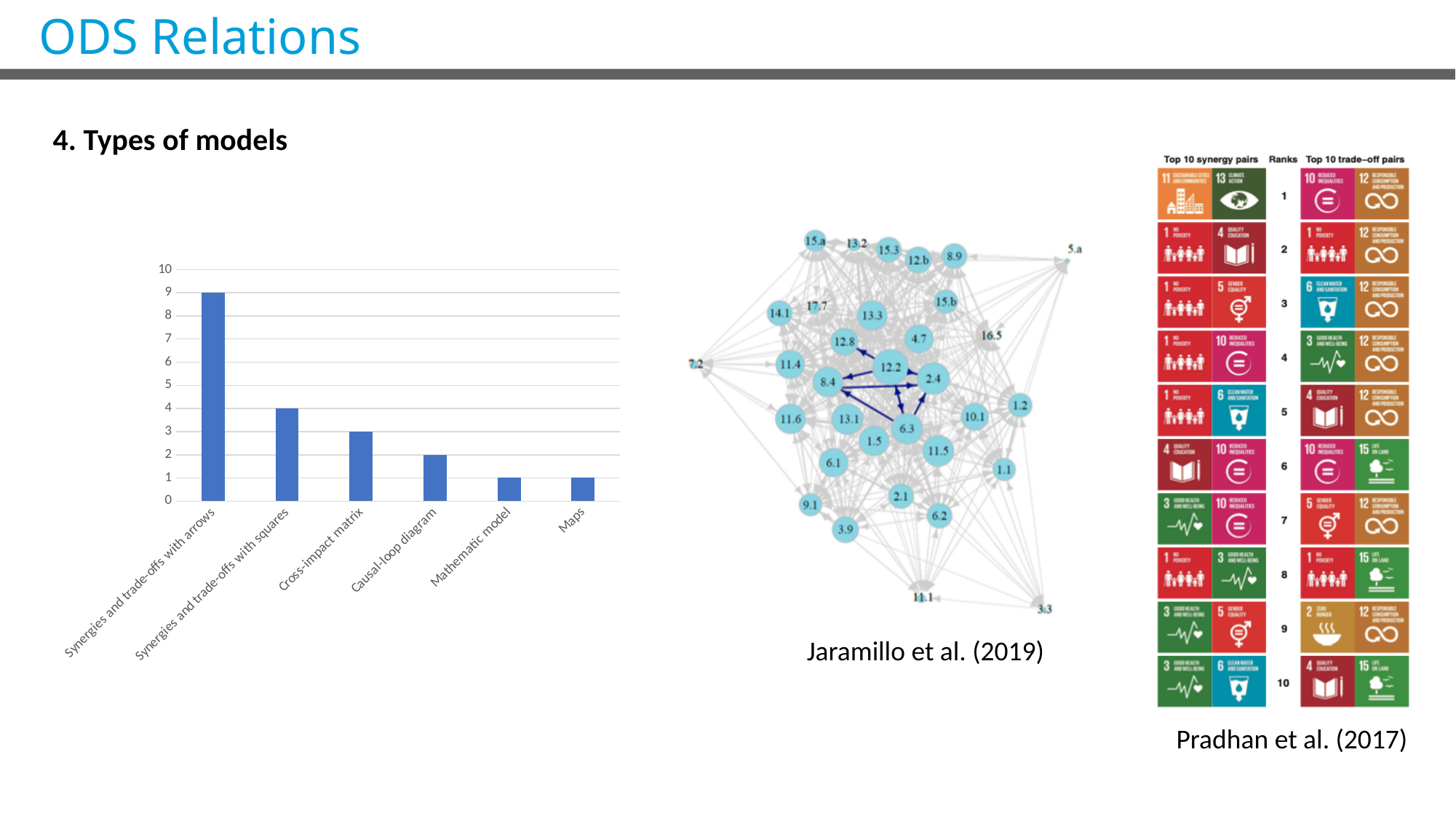
How many categories are shown in the bar chart on the left? 6 In the bar chart on the left, which is larger: the value for Cross-impact matrix or the value for Causal-loop diagram? Cross-impact matrix In the bar chart on the left, what is the value for Synergies and trade-offs with arrows? 9 In the bar chart on the left, what is the value for Synergies and trade-offs with squares? 4 What kind of chart is shown on the left of the slide? bar chart In the bar chart on the left, is the value for Synergies and trade-offs with arrows greater or less than 5? greater In the bar chart on the left, what is the difference between the values for Synergies and trade-offs with arrows and Synergies and trade-offs with squares? 5 In the bar chart on the left, what is the value for Causal-loop diagram? 2 In the bar chart on the left, what is the value for Maps? 1 In the bar chart on the left, do the values rise or fall from left to right along the x axis? fall In the bar chart on the left, what is the value for Cross-impact matrix? 3 In the bar chart on the left, which category has the highest value? Synergies and trade-offs with arrows